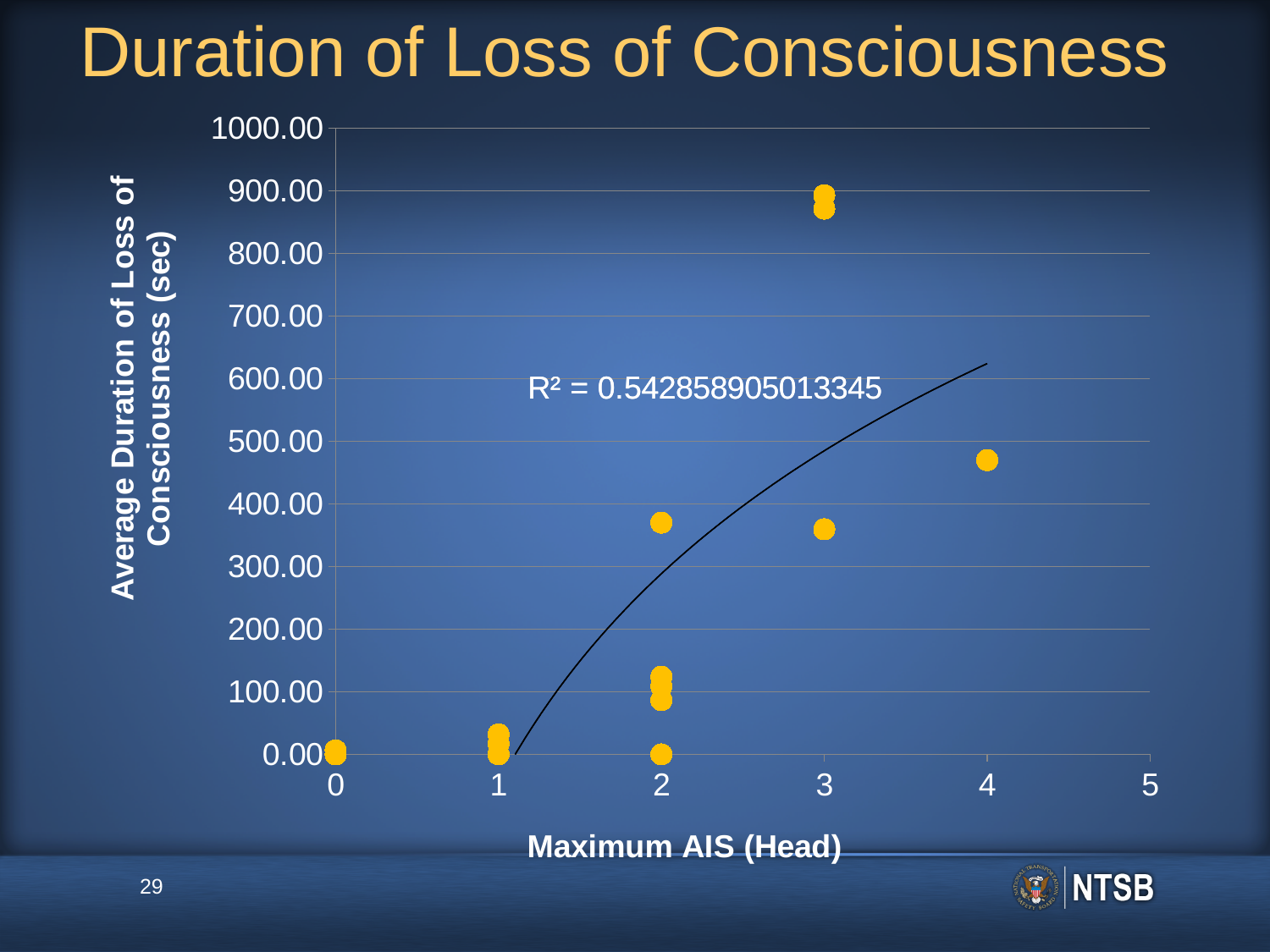
Are the highest points at Maximum AIS (Head) 3 greater or less than 800 seconds? greater Does the fitted trendline rise or fall as Maximum AIS (Head) increases? rises Is the value for the point at Maximum AIS (Head) 4 greater or less than 500? less What is the title of the chart? Duration of Loss of Consciousness Is the value for the point at Maximum AIS (Head) 4 greater or less than 400? greater What R² value is printed on the chart? 0.542858905013345 Which is larger: the single point at Maximum AIS (Head) 4 or the highest point at Maximum AIS (Head) 2? the point at 4 What kind of chart is shown on the slide? scatter chart At which Maximum AIS (Head) value do the highest plotted points appear? 3 What is the label of the x axis? Maximum AIS (Head) What is the highest value shown on the y axis? 1000.00